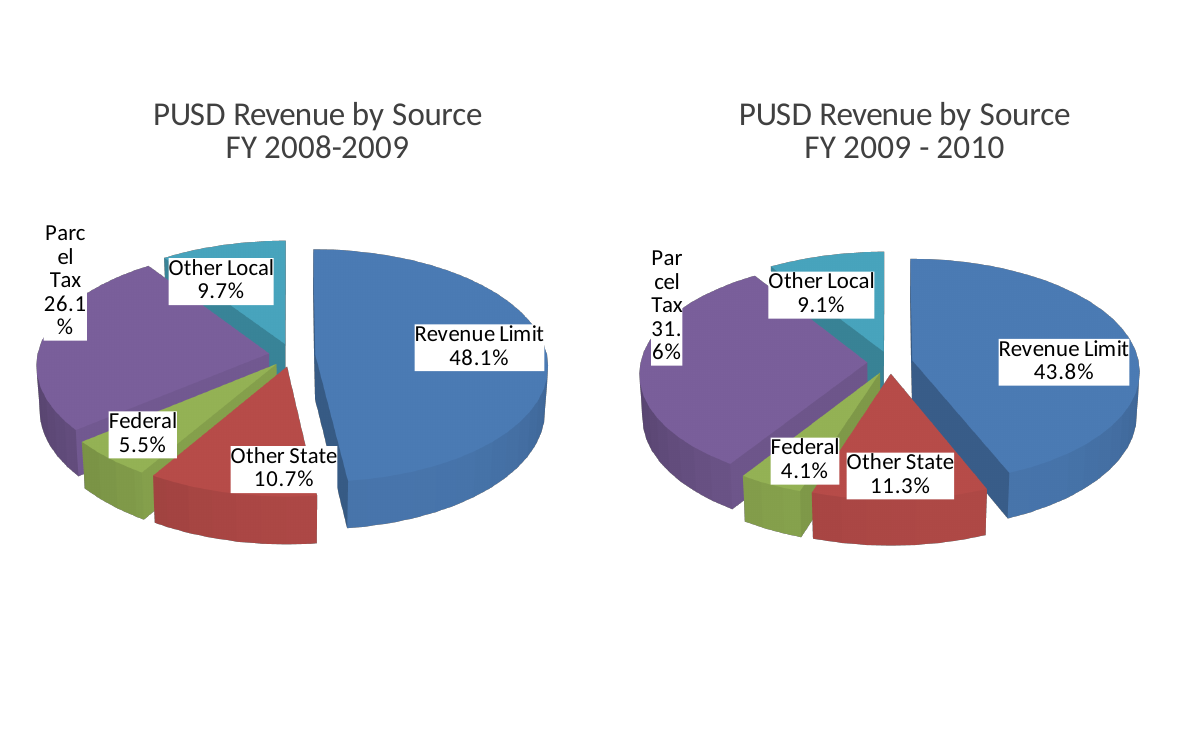
In the 'PUSD Revenue by Source FY 2009 - 2010' chart, which is larger: Other Local or Other State? Other State In the 'PUSD Revenue by Source FY 2009 - 2010' chart, what share does Parcel Tax have? 31.6% In the 'PUSD Revenue by Source FY 2009 - 2010' chart, what is the difference between the Other State share and the Federal share? 7.2 percentage points In the 'PUSD Revenue by Source FY 2008-2009' chart, what share does Federal have? 5.5% In the 'PUSD Revenue by Source FY 2008-2009' chart, what colour is the Revenue Limit slice? Blue In the 'PUSD Revenue by Source FY 2009 - 2010' chart, which source has the smallest share? Federal What kind of chart is the 'PUSD Revenue by Source FY 2009 - 2010' chart? Pie chart In the 'PUSD Revenue by Source FY 2008-2009' chart, what share does Revenue Limit have? 48.1% In the 'PUSD Revenue by Source FY 2008-2009' chart, what is the difference between the Revenue Limit share and the Parcel Tax share? 22 percentage points How many slices does the 'PUSD Revenue by Source FY 2008-2009' chart have? 5 In the 'PUSD Revenue by Source FY 2009 - 2010' chart, what share does Other State have? 11.3% In the 'PUSD Revenue by Source FY 2008-2009' chart, which source has the largest share? Revenue Limit